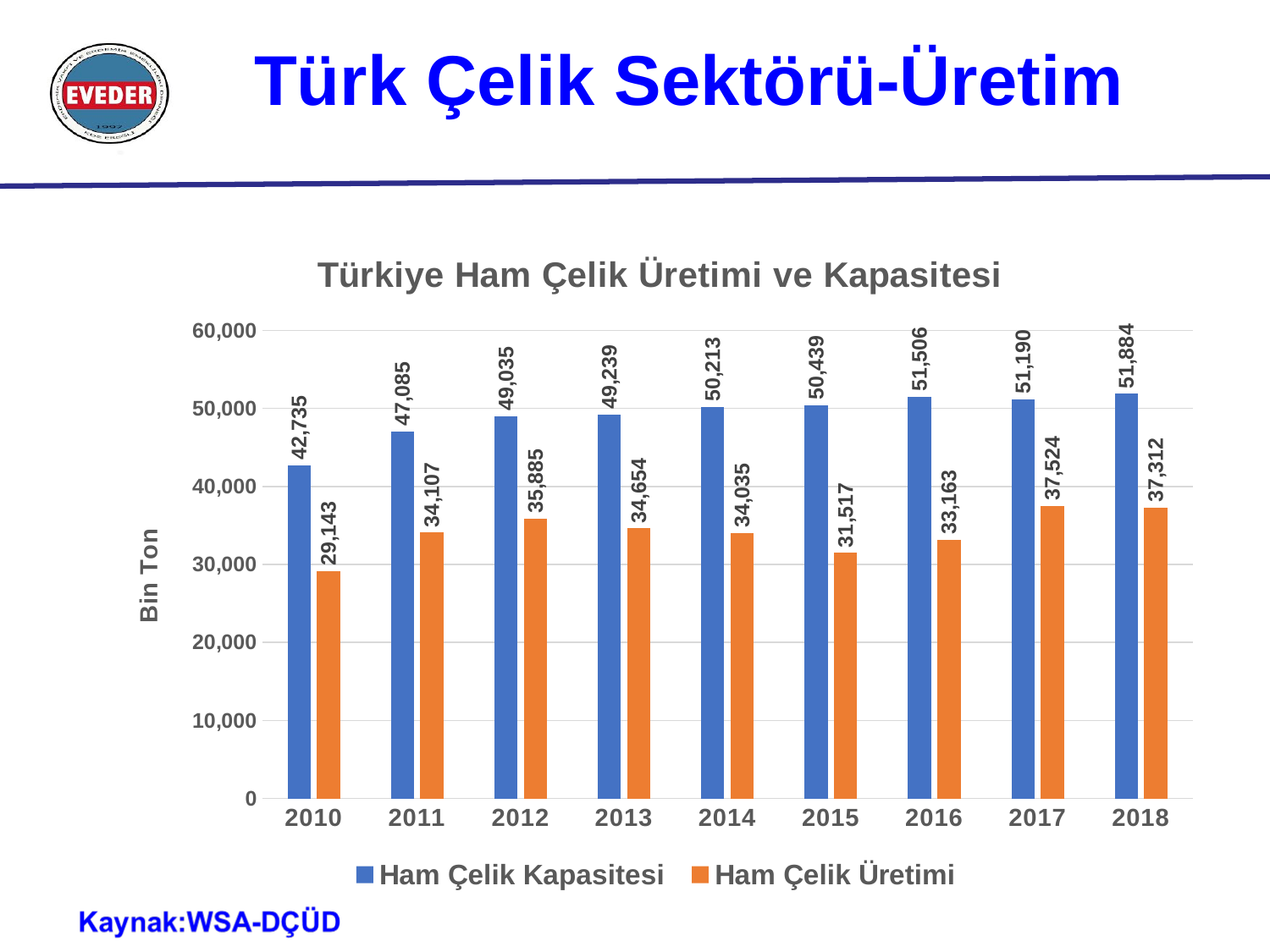
Is the Ham Çelik Üretimi value for 2010 greater or less than 30,000? less How many years are shown on the x axis? 9 Does Ham Çelik Kapasitesi rise or fall from 2010 to 2016? rise What kind of chart is shown on the slide? bar chart In which year is Ham Çelik Üretimi highest? 2017 Which year has the larger Ham Çelik Üretimi value, 2012 or 2013? 2012 How many series does the legend list? 2 What is the Ham Çelik Üretimi value for 2015? 31,517 What is the Ham Çelik Kapasitesi value for 2010? 42,735 What is the difference between Ham Çelik Kapasitesi and Ham Çelik Üretimi in 2018? 14,572 What is the title of the chart? Türkiye Ham Çelik Üretimi ve Kapasitesi In which year is Ham Çelik Kapasitesi lowest? 2010